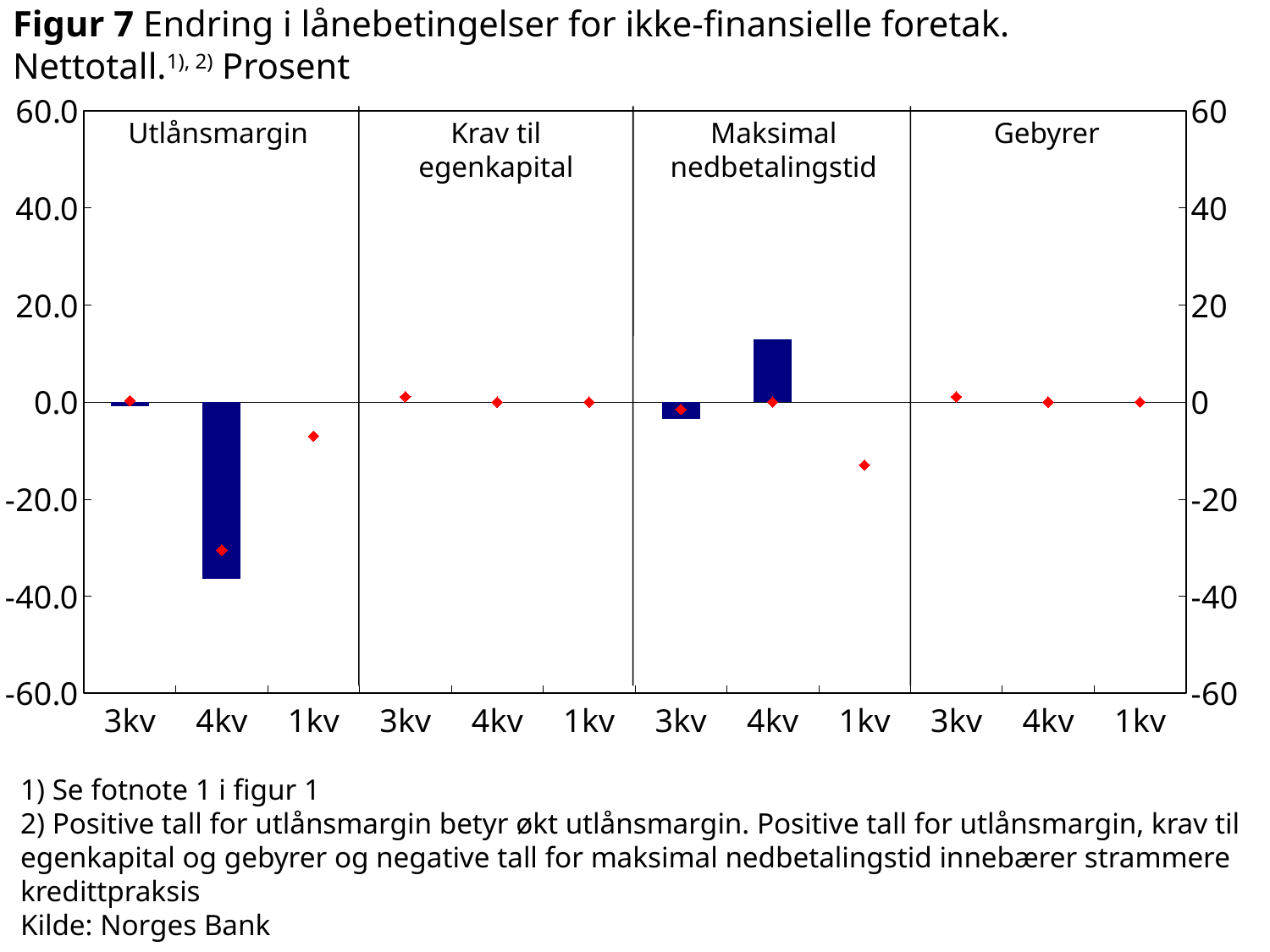
Is the bar for 4kv in the Utlånsmargin panel greater or less than -20? less Which panel and quarter has the highest bar in the chart? Maksimal nedbetalingstid, 4kv Is the red marker for 1kv in the Utlånsmargin panel greater or less than 0? less How many lending-condition panels (categories) does the chart have? 4 Which is lower: the 4kv bar in the Utlånsmargin panel or the 3kv bar in the Maksimal nedbetalingstid panel? Utlånsmargin 4kv Is the bar for 4kv in the Maksimal nedbetalingstid panel greater or less than 0? greater What source is cited below the chart? Norges Bank What kind of chart is shown on the slide? combination bar and line chart (bars with red diamond markers) How many quarters are shown within each panel of the chart? 3 Which panel and quarter has the lowest bar in the chart? Utlånsmargin, 4kv